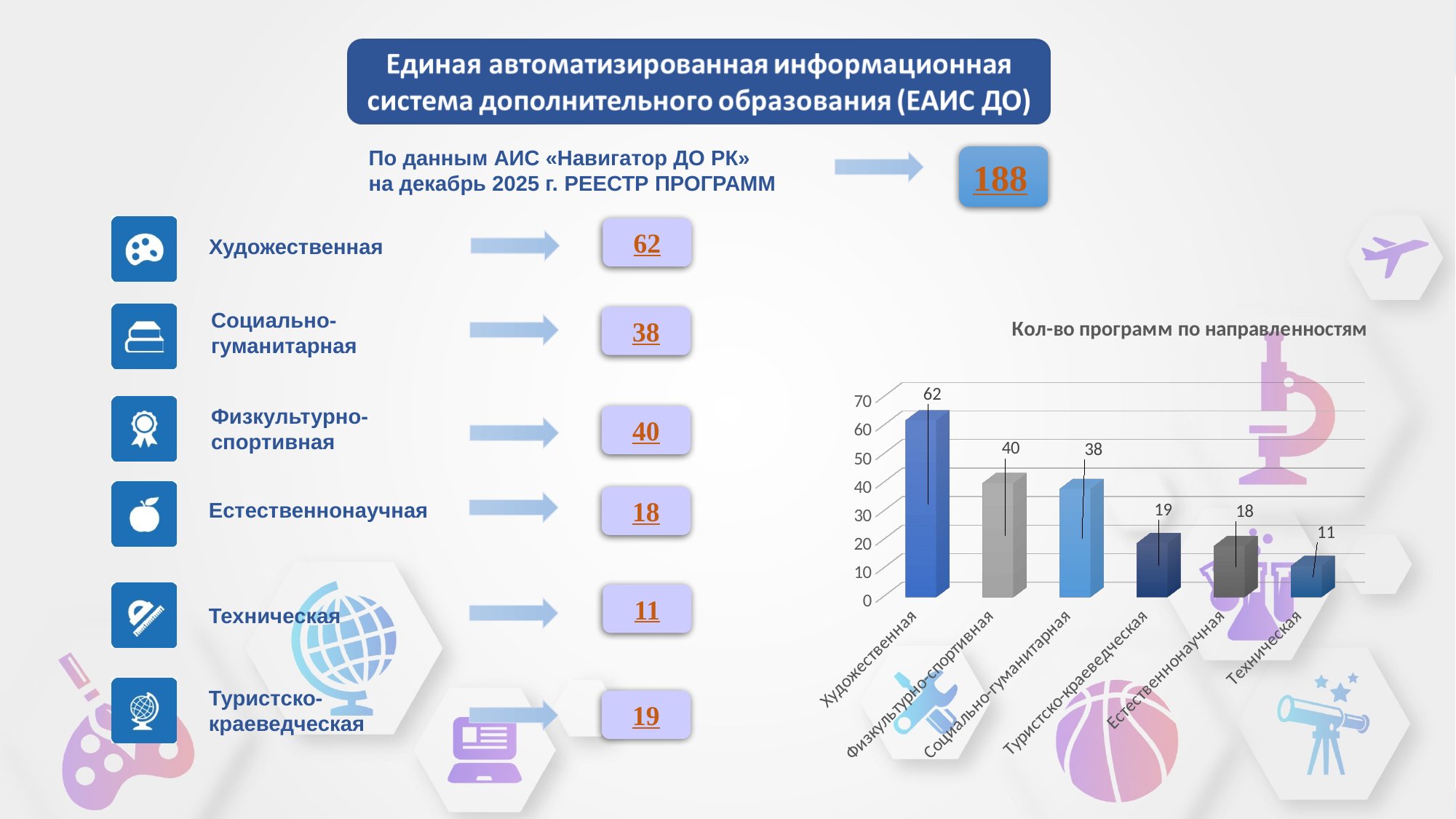
What is the value for Физкультурно-спортивная in the chart? 40 What is the value for Туристско-краеведческая in the chart? 19 What is the value for Художественная in the chart? 62 Which is larger, the value for Физкультурно-спортивная or the value for Социально-гуманитарная? Физкультурно-спортивная What is the difference between the values for Физкультурно-спортивная and Техническая? 29 How many categories are shown in the chart? 6 What is the title of the chart? Кол-во программ по направленностям What is the value for Техническая in the chart? 11 Which category has the highest value in the chart? Художественная Which category has the lowest value in the chart? Техническая What kind of chart is shown on the slide? Bar chart What is the difference between the values for Художественная and Социально-гуманитарная? 24